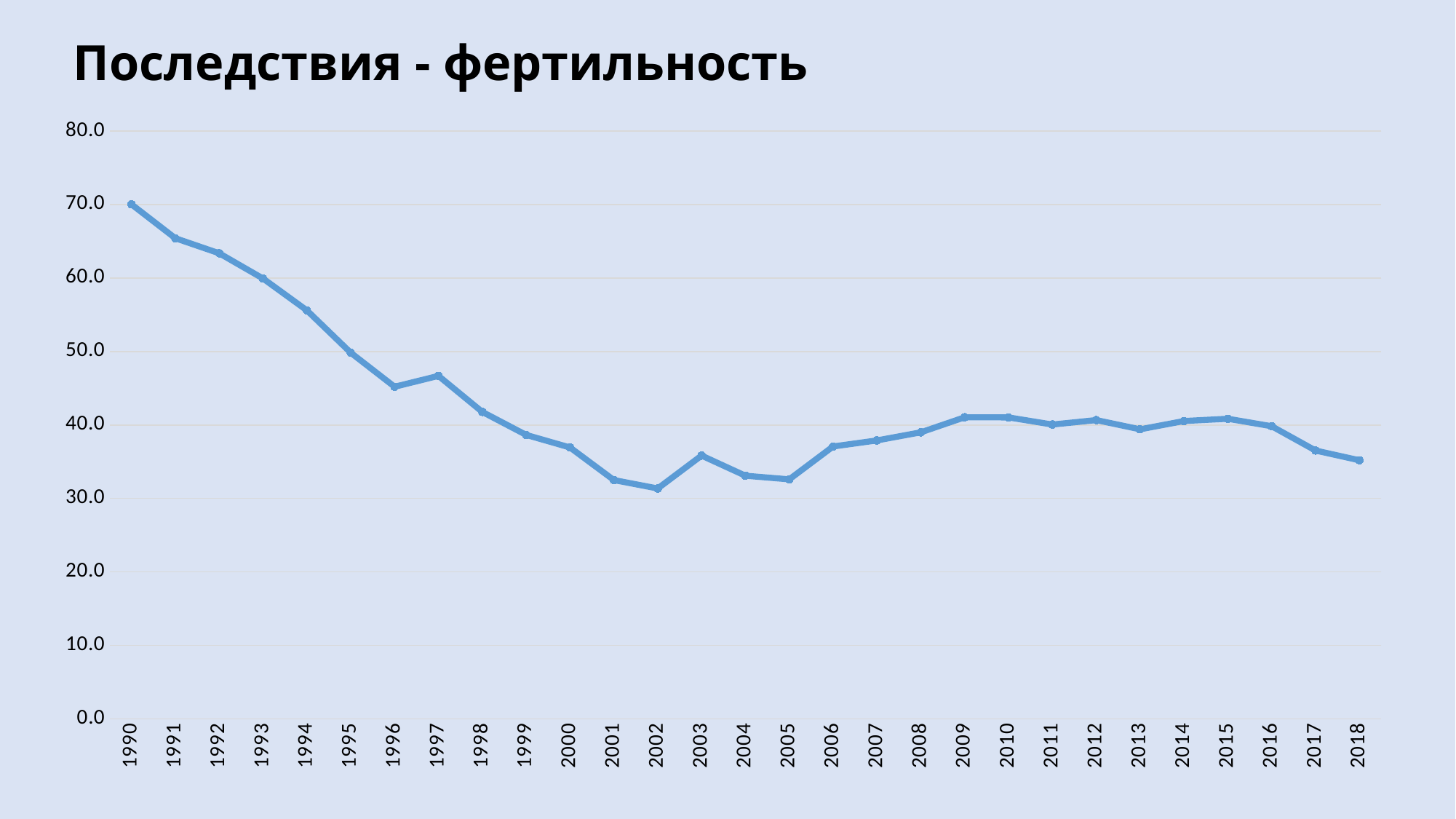
Is the value for 2017 greater or less than 40? less Is the value for 1996 greater or less than 50? less Which year has the lowest value? 2002 Is the value for 1991 greater or less than 60? greater What is the value for 1990? 70.0 Which is larger, the value for 1997 or the value for 1996? 1997 Which year has the highest value? 1990 What kind of chart is shown on the slide? line chart How many years are plotted along the x axis? 29 What is the title of the chart? Последствия - фертильность Overall, do the values rise or fall from 1990 to 2018? fall